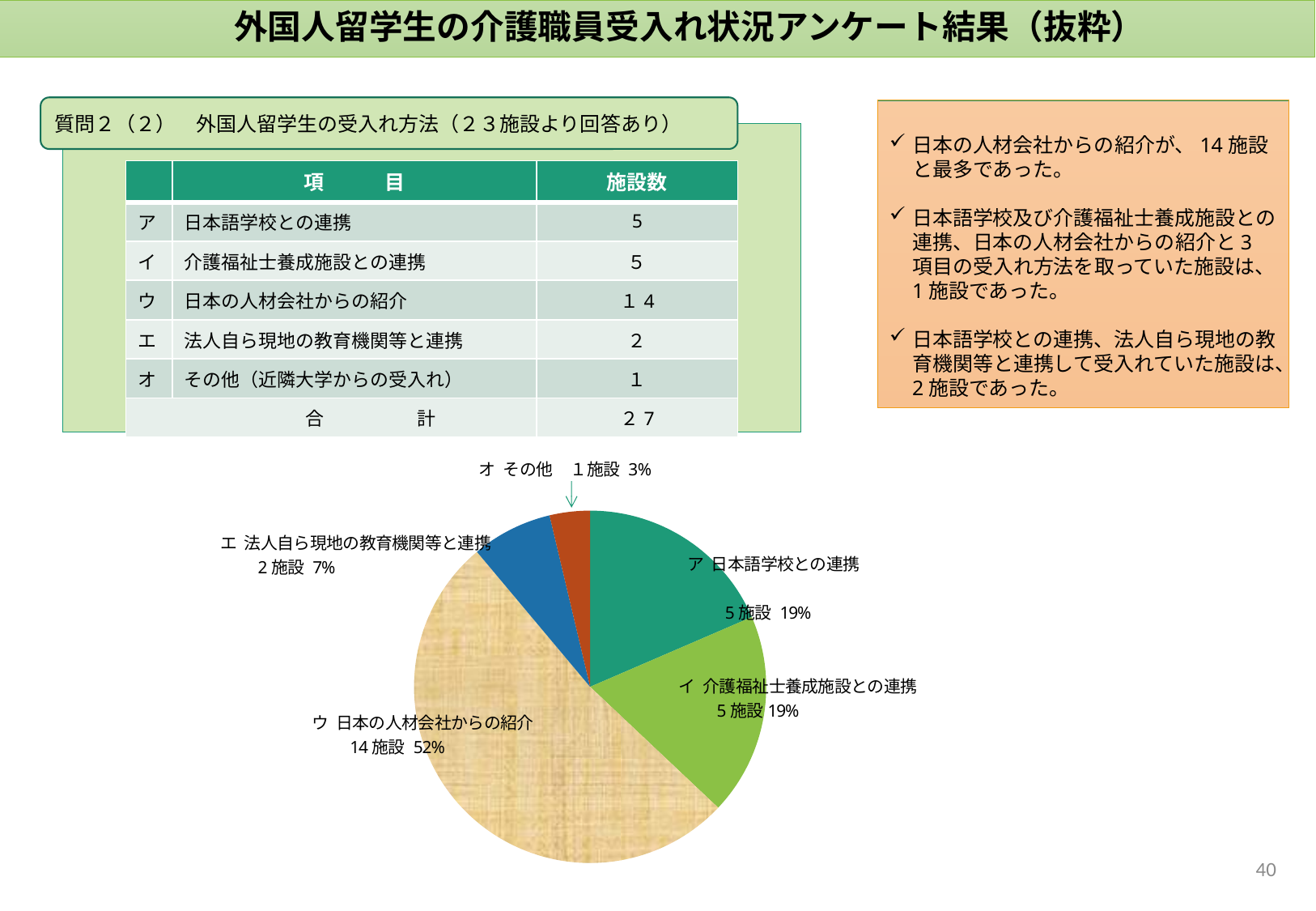
このスライドのグラフはどの種類のグラフですか？ 円グラフ 円グラフで最も割合が大きい項目はどれですか？ ウ 日本の人材会社からの紹介 円グラフで「ウ 日本の人材会社からの紹介」の施設数はいくつですか？ 14施設 円グラフで「ウ 日本の人材会社からの紹介」と「ア 日本語学校との連携」の施設数の差はいくつですか？ 9施設 円グラフには項目がいくつありますか？ 5 円グラフで「エ 法人自ら現地の教育機関等と連携」の割合は何％ですか？ 7% 円グラフで最も割合が小さい項目はどれですか？ オ その他 円グラフで「エ 法人自ら現地の教育機関等と連携」と「オ その他」では、どちらの施設数が多いですか？ エ 法人自ら現地の教育機関等と連携 円グラフで「ア 日本語学校との連携」の扇形は何色ですか？ 緑（青緑） 円グラフで「ウ 日本の人材会社からの紹介」の割合は何％ですか？ 52% 円グラフで「オ その他」の施設数はいくつですか？ 1施設 円グラフで「イ 介護福祉士養成施設との連携」の割合は何％ですか？ 19%